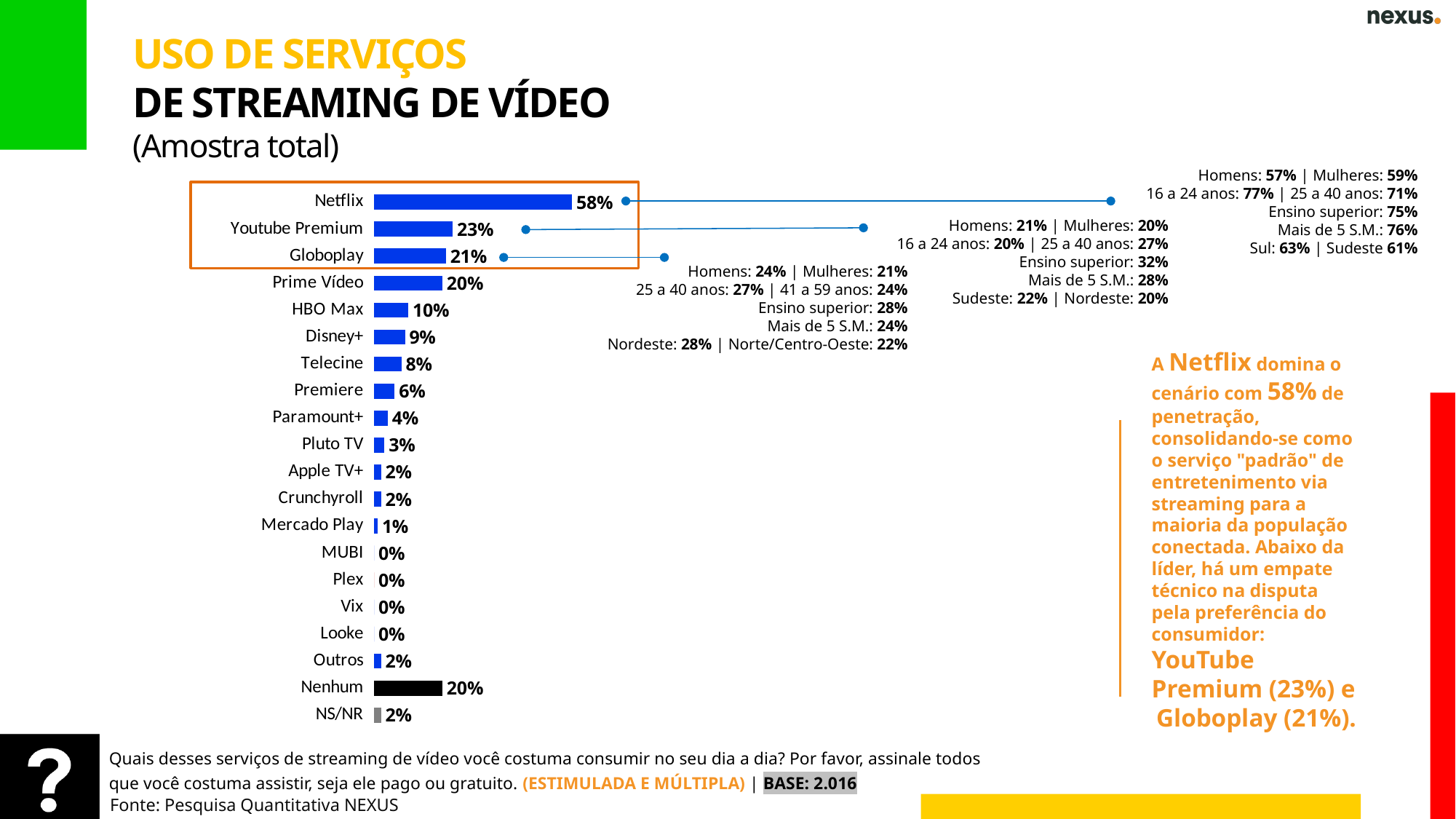
What is the value shown for Globoplay? 21% Which has a larger value, Youtube Premium or Prime Vídeo? Youtube Premium Which has a larger value, Telecine or Paramount+? Telecine What type of chart is shown on the slide? Bar chart What percentage of respondents use Netflix? 58% What is the value for Nenhum (none)? 20% What is the difference between the values for Netflix and Youtube Premium? 35 percentage points Which streaming service has the highest percentage in the chart? Netflix Which three services are enclosed in the orange box at the top of the chart? Netflix, Youtube Premium and Globoplay What is the difference between the values for Prime Vídeo and Disney+? 11 percentage points How many categories are listed in the bar chart? 20 What percentage is shown for HBO Max? 10%